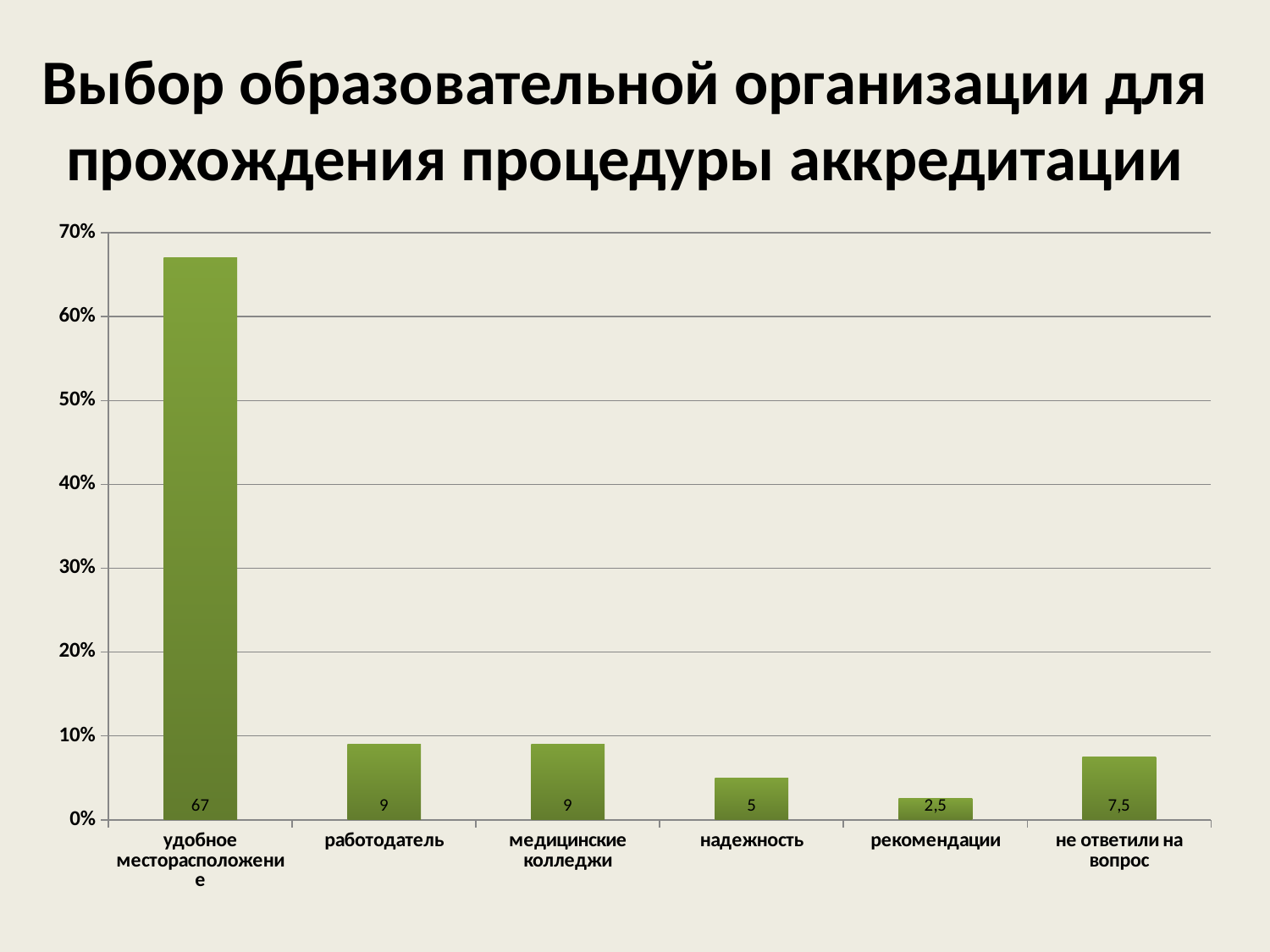
How many categories are shown on the x axis? 6 What is the value shown for «не ответили на вопрос»? 7,5 What is the value shown for «удобное месторасположение»? 67 Which category has the highest value? удобное месторасположение What is the difference between the values for «удобное месторасположение» and «работодатель»? 58 Which is larger, the value for «надежность» or the value for «не ответили на вопрос»? не ответили на вопрос What is the value shown for «надежность»? 5 What is the value shown for «рекомендации»? 2,5 What kind of chart is shown on the slide? bar chart Which category has the lowest value? рекомендации Is the value for «удобное месторасположение» greater or less than 60%? greater What is the difference between the values for «не ответили на вопрос» and «рекомендации»? 5